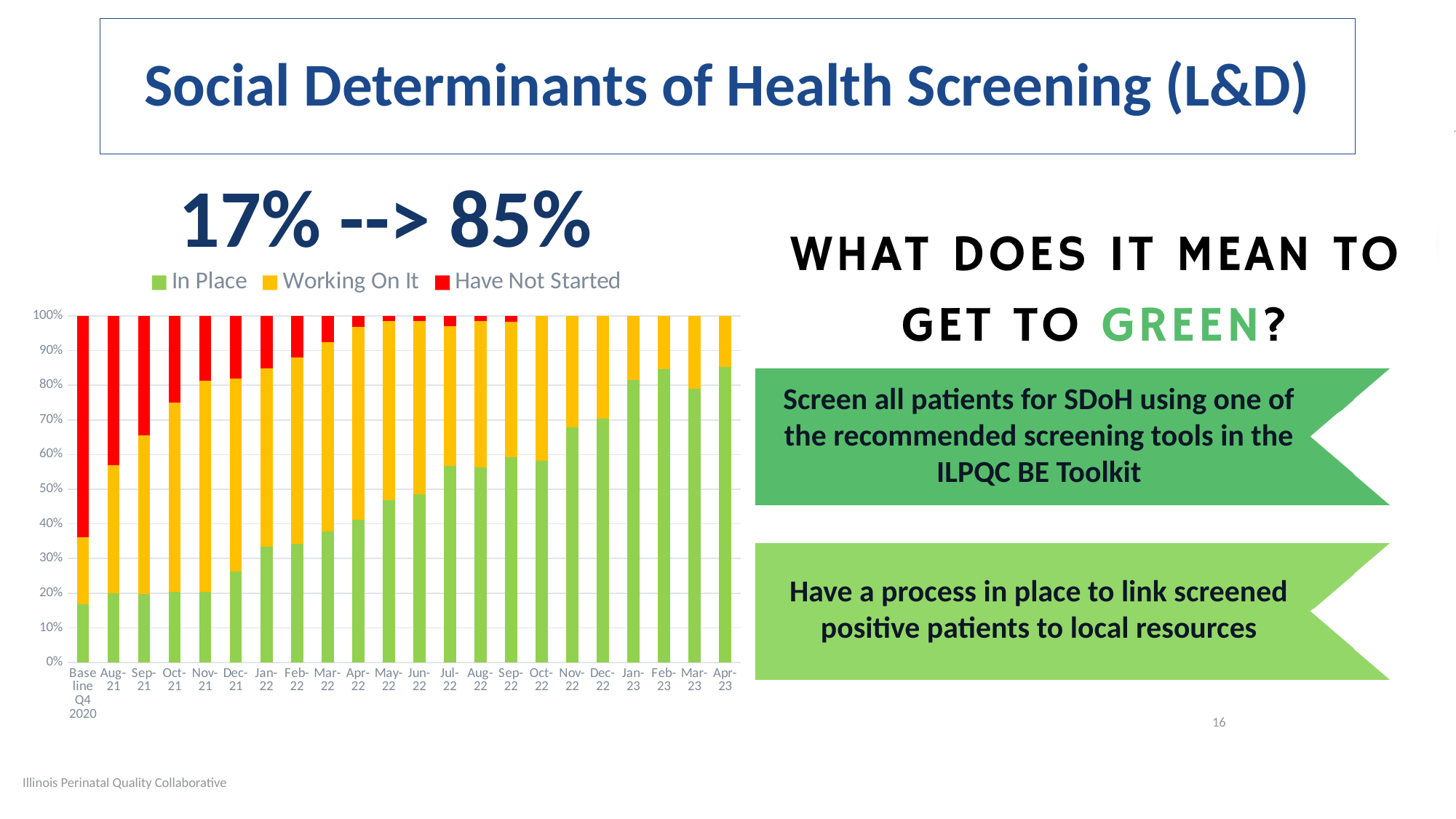
Which period has the larger 'In Place' share, Jun-22 or Dec-22? Dec-22 How many time periods (bars) are plotted on the x axis of the chart? 22 Which period has the highest 'In Place' share in the chart? Apr-23 What are the three series named in the chart legend? In Place, Working On It, Have Not Started Which colour represents the 'In Place' series in the chart? Green Is the 'In Place' share for Baseline Q4 2020 greater or less than 30%? less Is the 'In Place' share for Apr-23 greater or less than 80%? greater Which period has the lowest 'In Place' share in the chart? Baseline Q4 2020 Is the 'In Place' share for Dec-22 greater or less than 60%? greater What kind of chart is shown on the slide? Stacked bar chart Does the 'In Place' share rise or fall from the Baseline Q4 2020 bar to the Apr-23 bar? Rise How many series does the chart legend list? 3